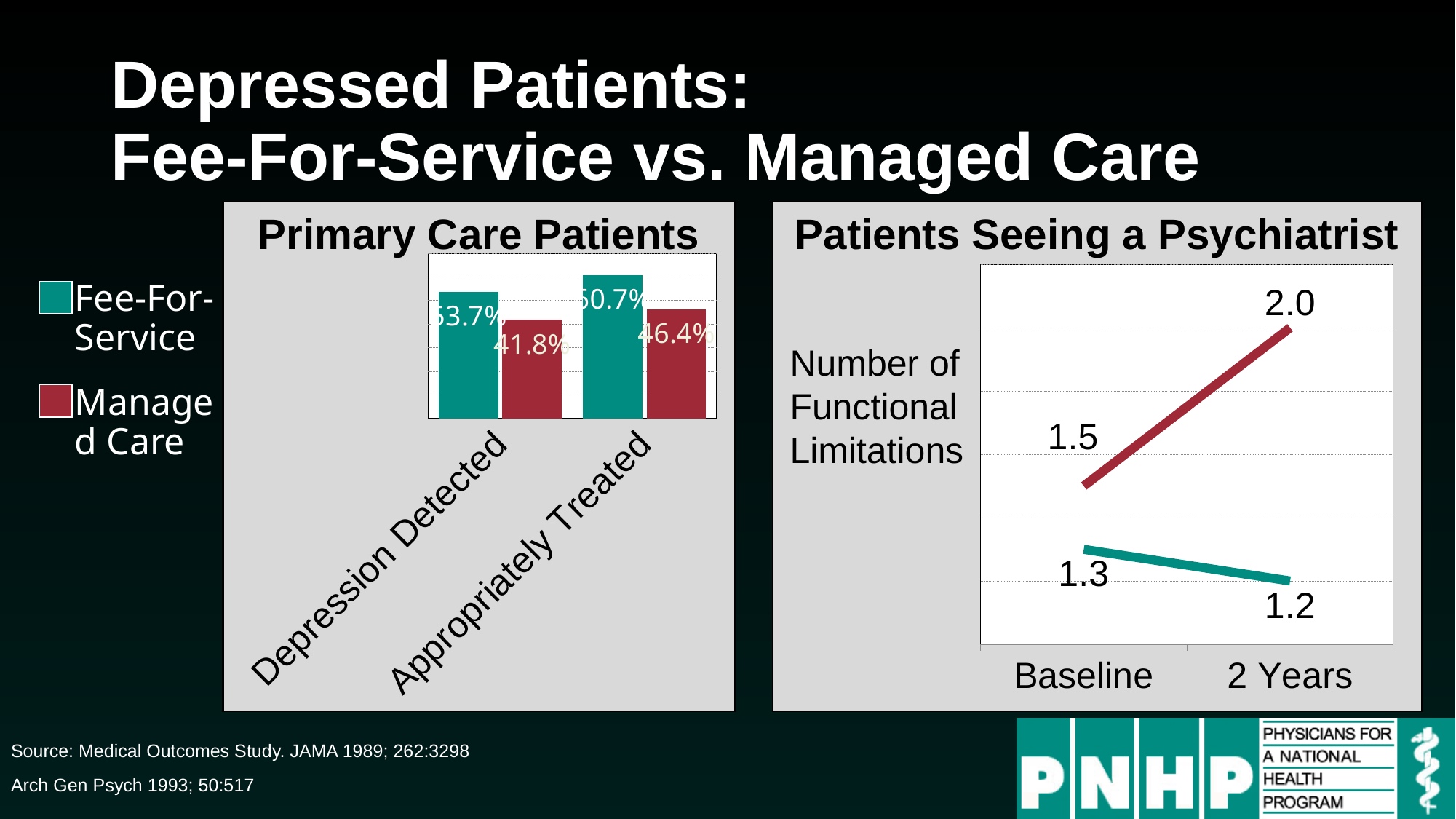
In the Primary Care Patients chart, what is the Managed Care value for Appropriately Treated? 46.4% In the Patients Seeing a Psychiatrist chart, does the Managed Care line rise or fall from Baseline to 2 Years? Rise In the Patients Seeing a Psychiatrist chart, what is the difference between the Managed Care values at 2 Years and Baseline? 0.5 In the Primary Care Patients chart, which is larger for Appropriately Treated: Fee-For-Service or Managed Care? Fee-For-Service In the Primary Care Patients chart, what is the difference between the Managed Care values for Appropriately Treated and Depression Detected? 4.6% How many series does the legend list for the charts? 2 How many categories are shown on the x axis of the Primary Care Patients chart? 2 What kind of chart is the Primary Care Patients chart? Bar chart In the Patients Seeing a Psychiatrist chart, what is the Fee-For-Service value at Baseline? 1.3 In the Primary Care Patients chart, which is larger for Depression Detected: Fee-For-Service or Managed Care? Fee-For-Service In the Primary Care Patients chart, what is the Managed Care value for Depression Detected? 41.8% In the Patients Seeing a Psychiatrist chart, what is the Managed Care value at 2 Years? 2.0